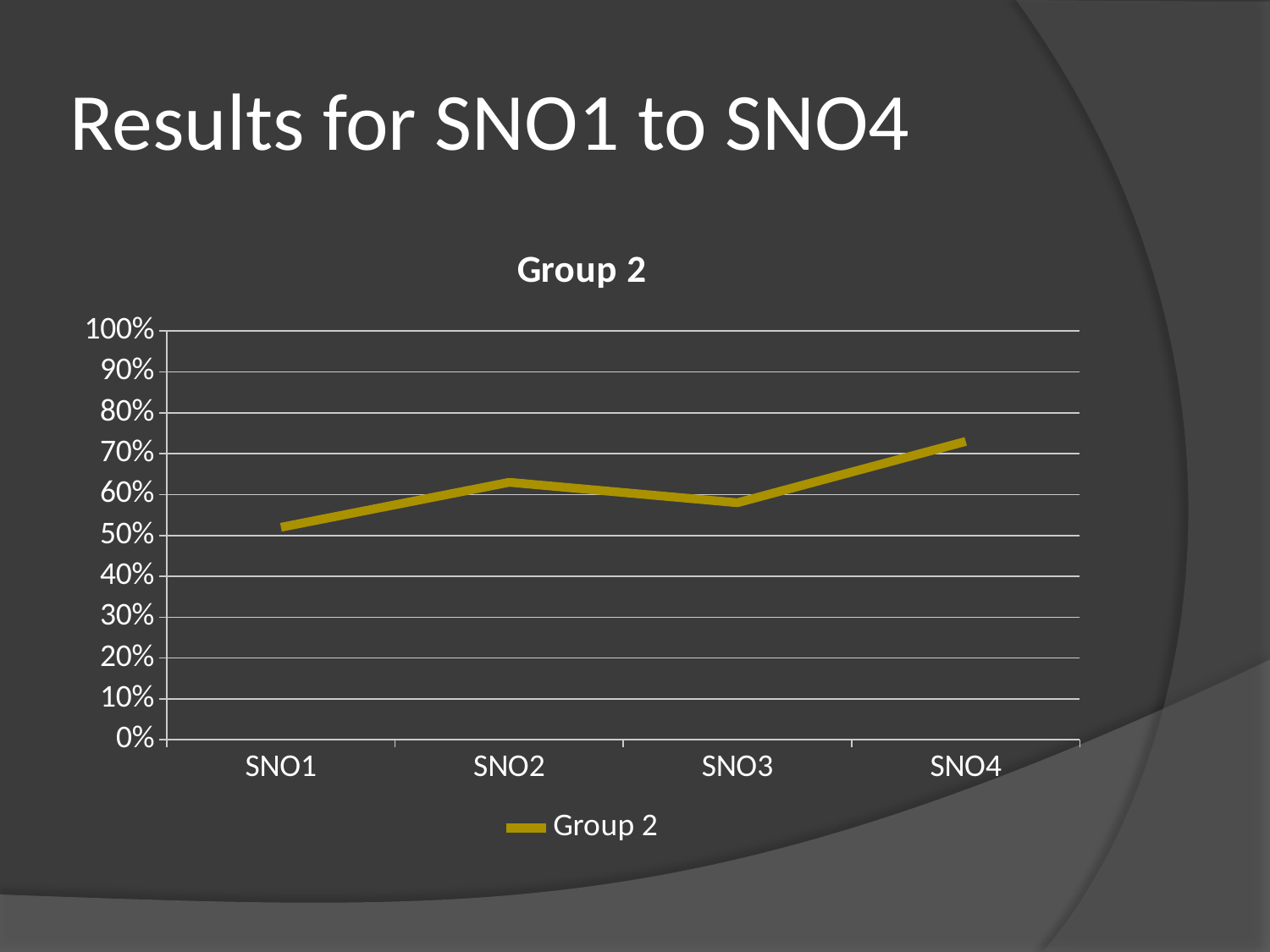
Is the value for SNO4 greater or less than 70%? greater What is the title of the chart? Group 2 How many series does the legend list? 1 Which category has the highest value? SNO4 What kind of chart is shown on the slide? line chart How many categories are plotted along the x axis? 4 Which is larger, the value for SNO4 or the value for SNO1? SNO4 Is the value for SNO1 greater or less than 60%? less Is the value for SNO4 greater or less than 80%? less Does the value rise or fall from SNO3 to SNO4? rise Which category has the lowest value? SNO1